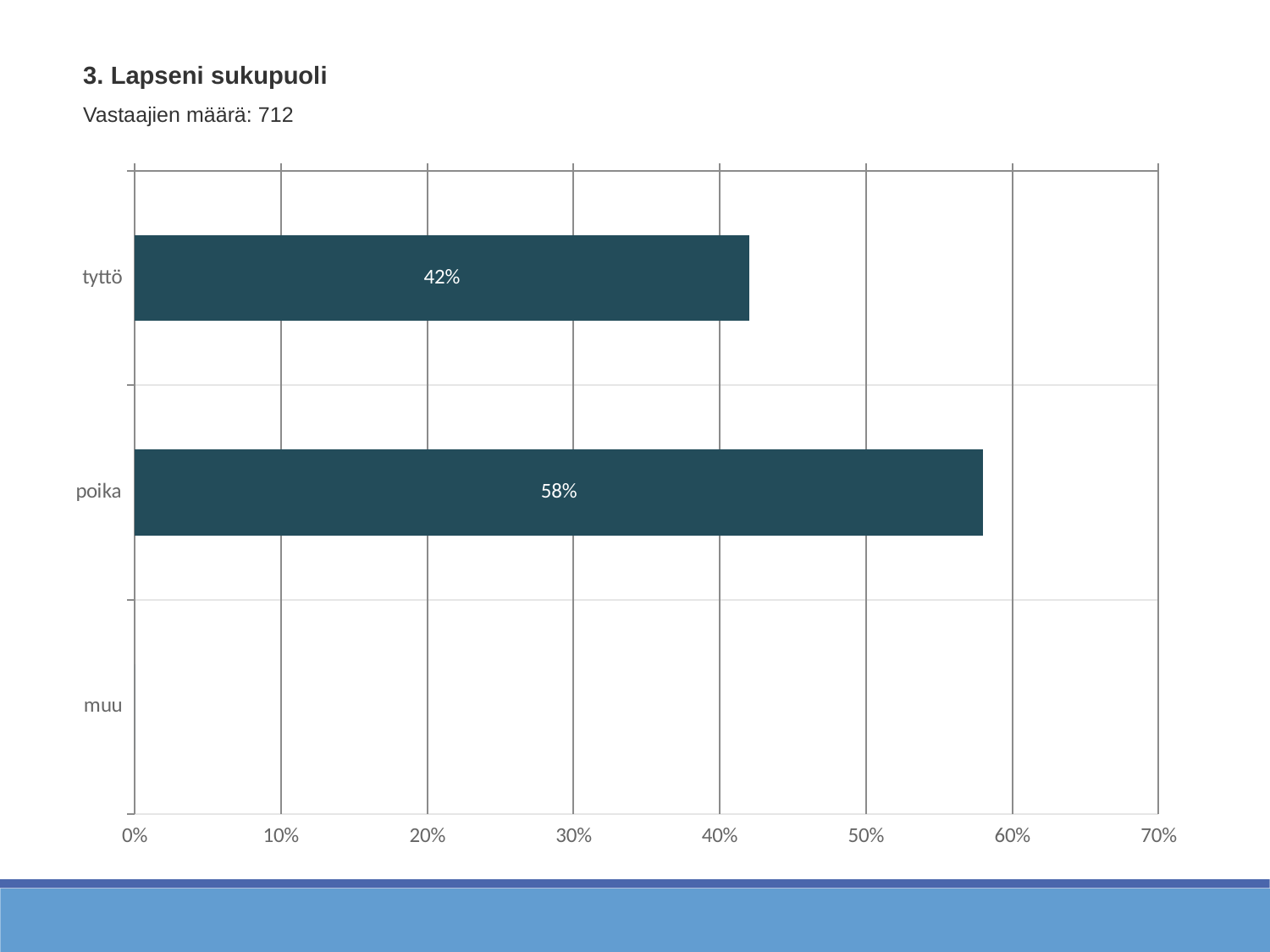
Is the value for tyttö greater or less than 50%? less What is the title of the chart? 3. Lapseni sukupuoli Is the value for poika greater or less than 50%? greater What kind of chart is shown on the slide? bar chart What is the value for poika? 58% Which category has the highest value? poika How many categories are shown on the y axis? 3 What is the value for tyttö? 42% How many respondents (Vastaajien määrä) are reported on the slide? 712 What is the difference between the values for poika and tyttö? 16% Which is larger, the value for tyttö or the value for poika? poika What is the highest value shown on the x axis? 70%